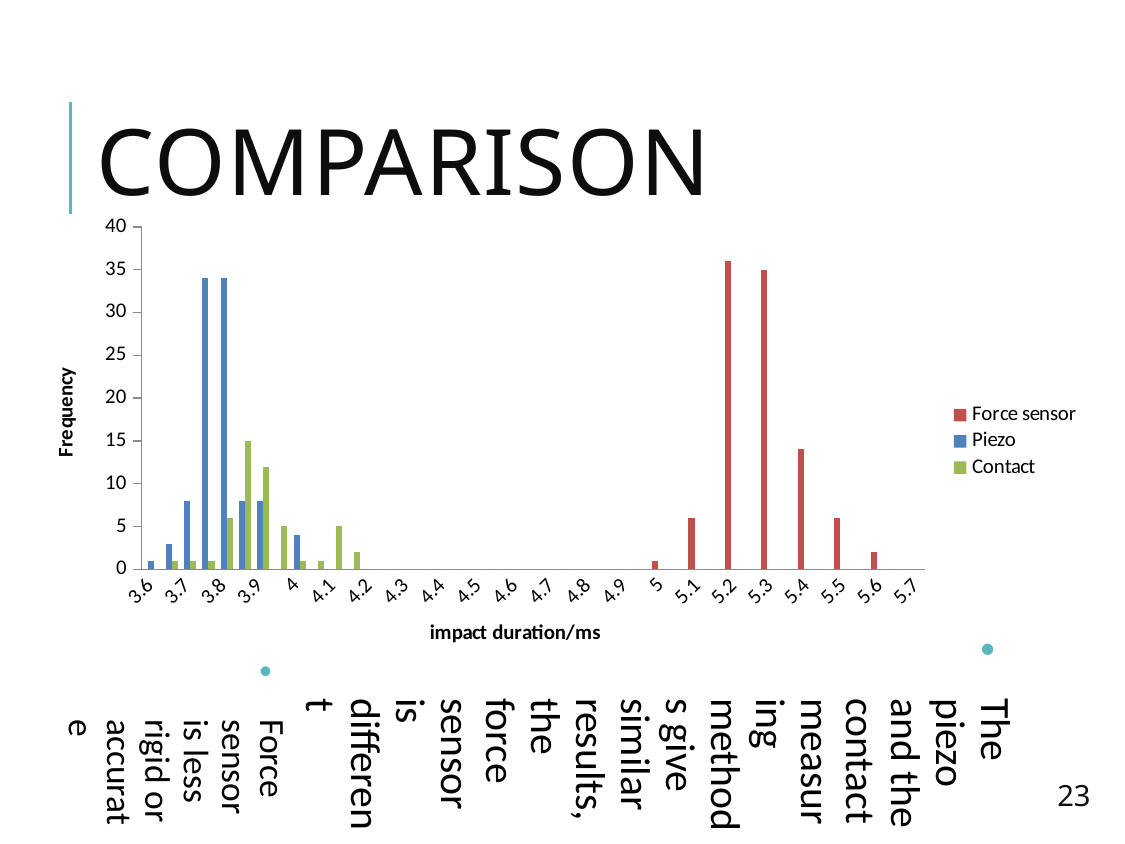
Is the tallest Force sensor bar greater or less than 30? greater How many series does the legend list? 3 What is the title of the x axis? impact duration/ms Is the tallest Contact bar greater or less than 20? less What are the three series named in the legend? Force sensor, Piezo, Contact Is the tallest Piezo bar greater or less than 30? greater What kind of chart is shown on the slide? bar chart Which series has its bars at the highest impact durations (around 5.0 to 5.6 ms)? Force sensor Which series has the lowest peak frequency? Contact How many tick labels are shown on the x axis? 22